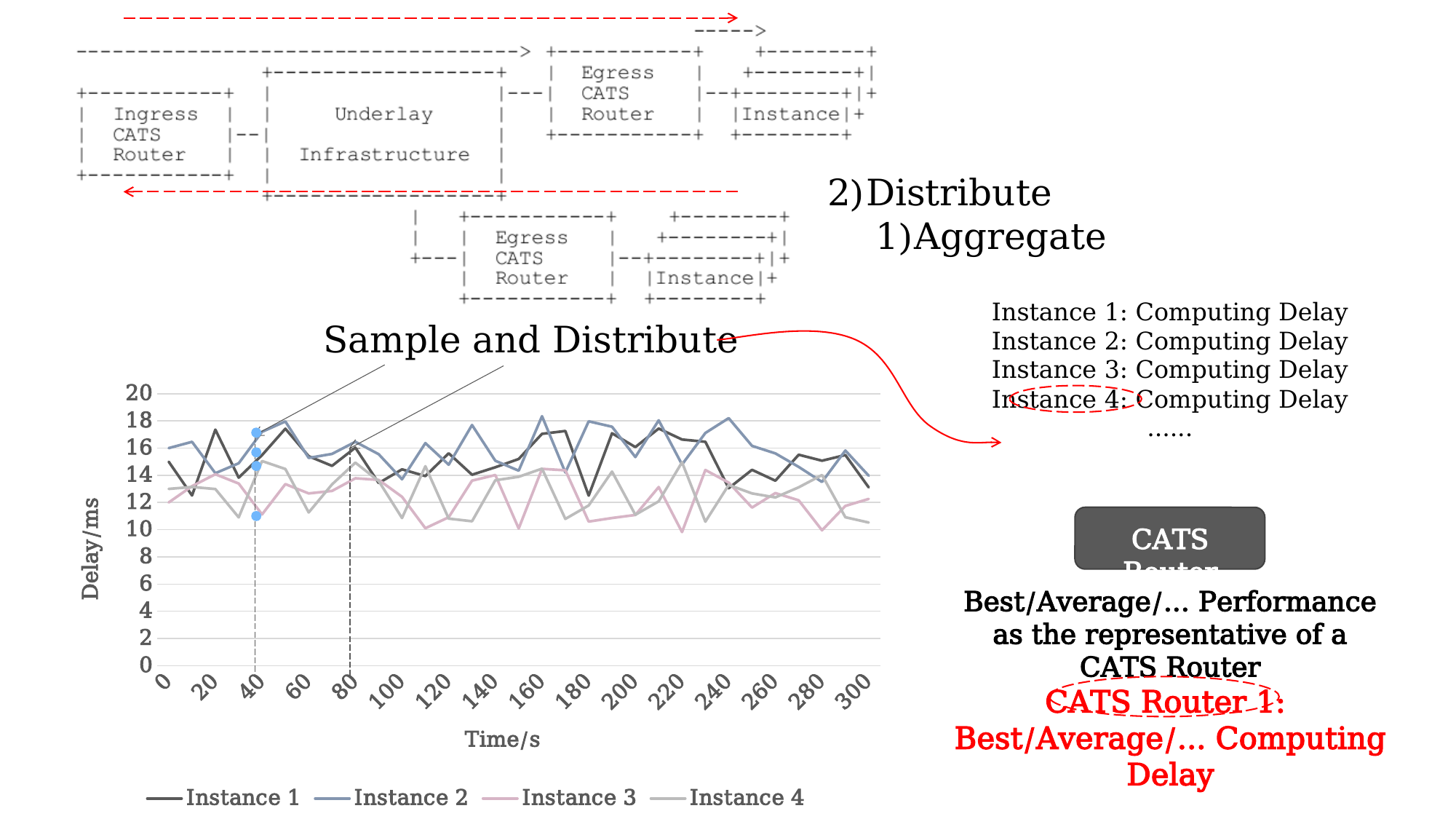
At time 40, which is larger: the value for Instance 1 or the value for Instance 3? Instance 1 What kind of chart is shown on the slide? line chart Is the value for Instance 3 at time 220 greater or less than 12? less Is the value for Instance 3 at time 40 greater or less than 14? less How many series does the chart's legend list? 4 Is the value for Instance 2 at time 160 greater or less than 16? greater What is the title of the chart's vertical axis? Delay/ms At time 160, which is larger: the value for Instance 2 or the value for Instance 3? Instance 2 What is the title of the chart's horizontal axis? Time/s How many tick labels are shown on the chart's x axis? 16